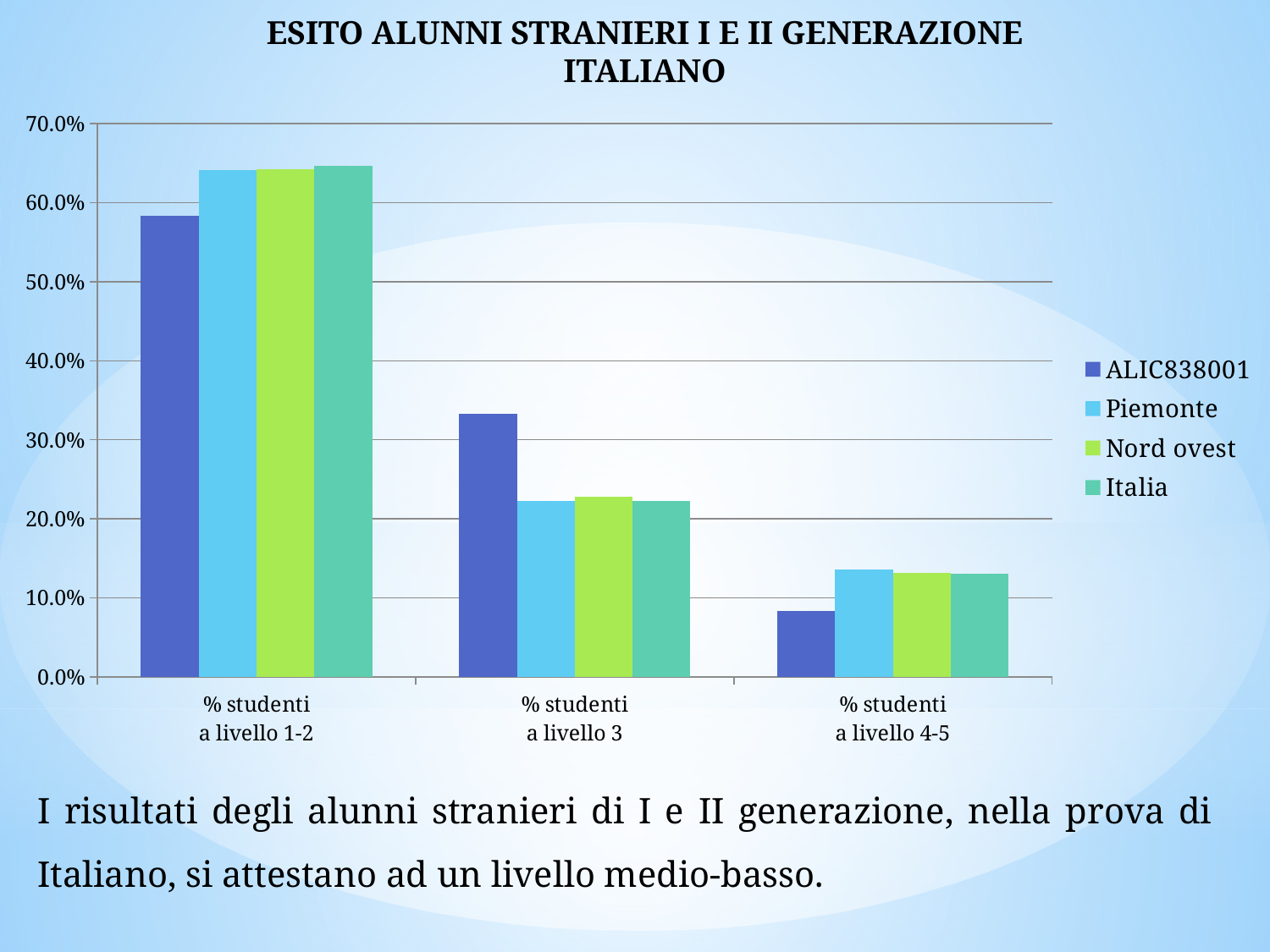
What is the title of the chart? ESITO ALUNNI STRANIERI I E II GENERAZIONE ITALIANO In '% studenti a livello 1-2', which is larger: ALIC838001 or Italia? Italia Is the value for ALIC838001 in '% studenti a livello 1-2' greater or less than 60.0%? less How many series does the legend list? 4 For the ALIC838001 series, which category has the highest value? % studenti a livello 1-2 How many categories are shown on the x axis? 3 Is the value for Italia in '% studenti a livello 1-2' greater or less than 60.0%? greater For the ALIC838001 series, which category has the lowest value? % studenti a livello 4-5 In '% studenti a livello 3', which is larger: ALIC838001 or Piemonte? ALIC838001 Is the value for ALIC838001 in '% studenti a livello 3' greater or less than 30.0%? greater What kind of chart is shown on the slide? bar chart